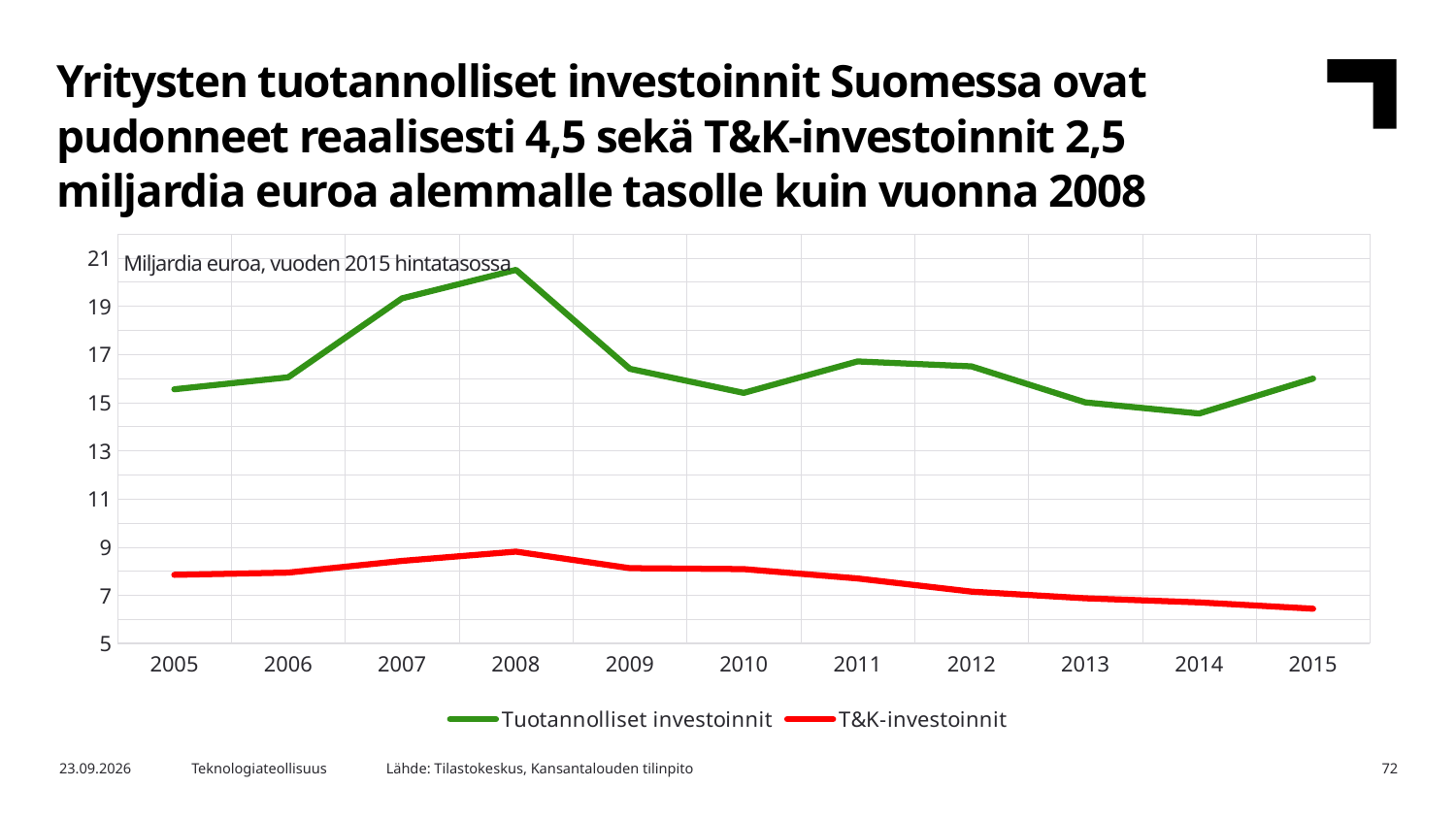
What unit is stated in the label inside the chart area? Miljardia euroa, vuoden 2015 hintatasossa How many series does the legend list? 2 Is the value for T&K-investoinnit in 2015 greater or less than 7? less In which year does the Tuotannolliset investoinnit series reach its lowest value? 2014 Does the T&K-investoinnit series rise or fall from 2008 to 2015? fall How many years are shown on the x axis? 11 Is the value for Tuotannolliset investoinnit in 2008 greater or less than 19? greater In which year does the T&K-investoinnit series reach its highest value? 2008 In which year does the T&K-investoinnit series reach its lowest value? 2015 In which year does the Tuotannolliset investoinnit series reach its highest value? 2008 What kind of chart is shown on the slide? line chart Which series has the larger value in 2010, Tuotannolliset investoinnit or T&K-investoinnit? Tuotannolliset investoinnit